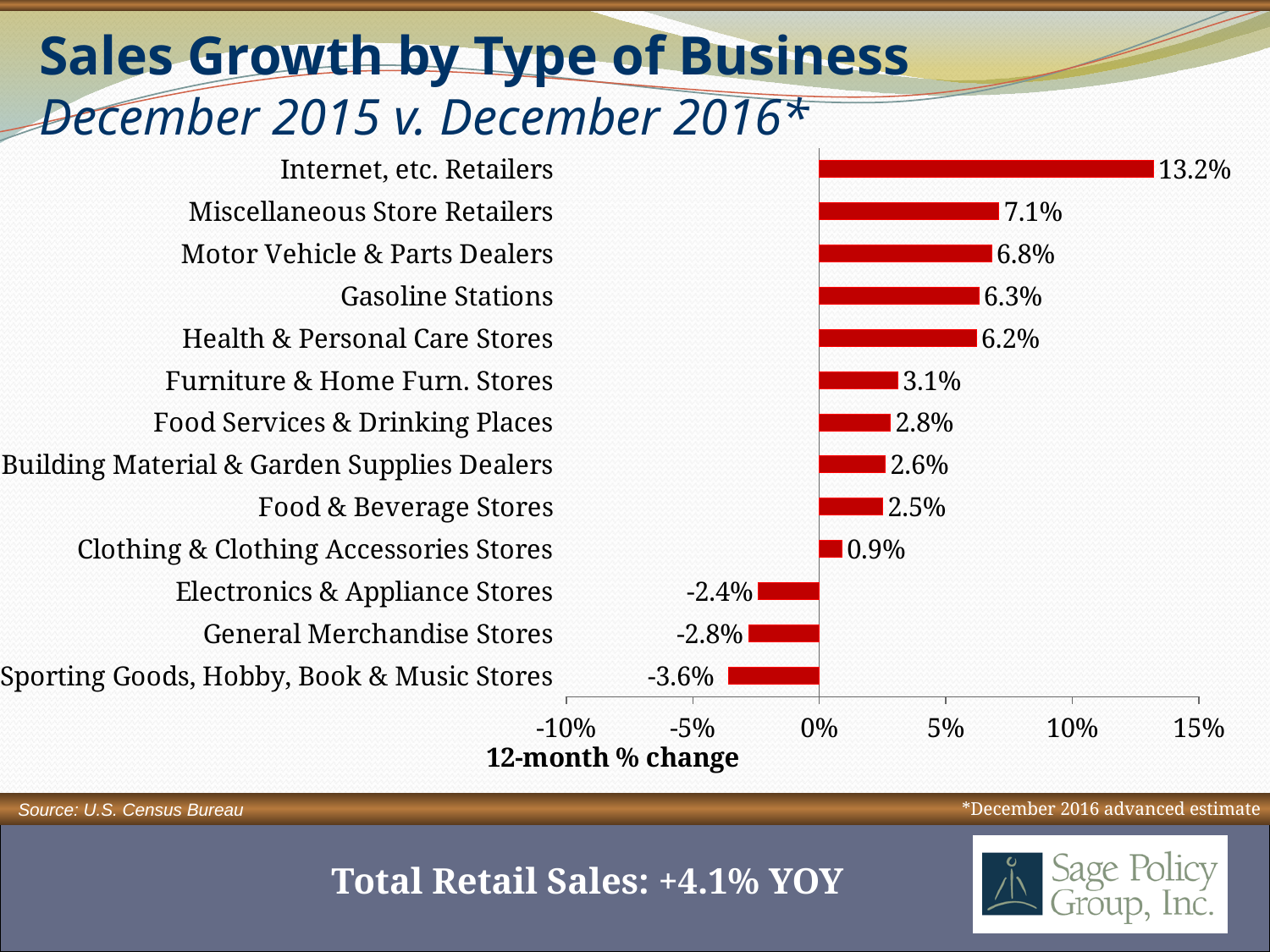
What kind of chart is shown on the slide? Bar chart Which type of business has the lowest 12-month % change? Sporting Goods, Hobby, Book & Music Stores What is the 12-month % change for Gasoline Stations? 6.3% What is the difference between the 12-month % change for Internet, etc. Retailers and Miscellaneous Store Retailers? 6.1% What is the label of the horizontal axis? 12-month % change What is the 12-month % change for Internet, etc. Retailers? 13.2% What is the 12-month % change for Sporting Goods, Hobby, Book & Music Stores? -3.6% Which has a larger 12-month % change, Furniture & Home Furn. Stores or Food & Beverage Stores? Furniture & Home Furn. Stores Is the value for Motor Vehicle & Parts Dealers greater or less than 5%? greater How many types of business are shown in the chart? 13 How many types of business show a negative 12-month % change? 3 Which type of business has the highest 12-month % change? Internet, etc. Retailers